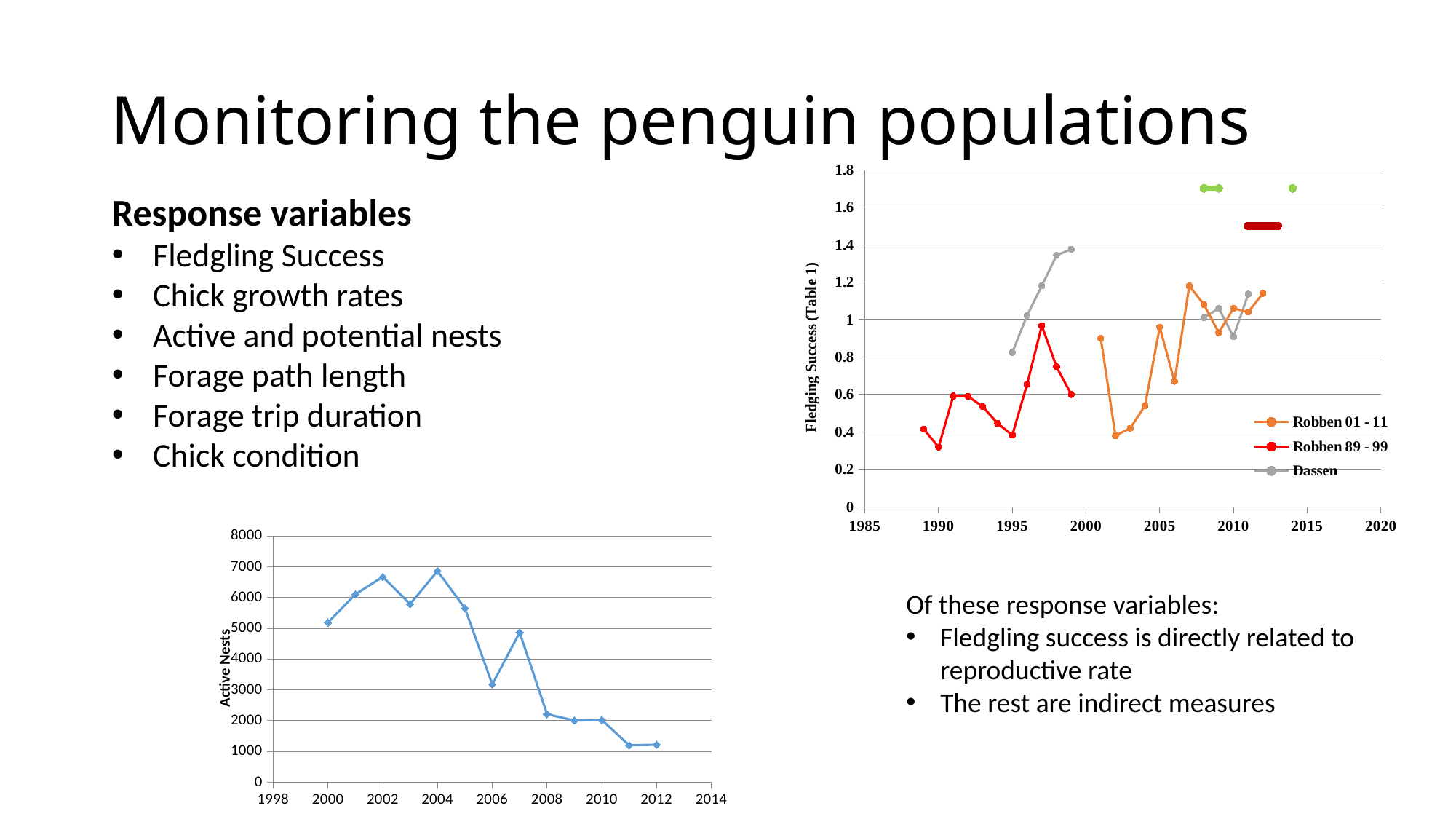
In the bottom-left Active Nests chart, do the values generally rise or fall from 2004 to 2012? fall What is the y-axis label of the top-right chart? Fledging Success (Table 1) In the bottom-left Active Nests chart, is the value for 2000 greater or less than 5000? greater In the top-right Fledging Success chart, is the Dassen value for 1999 greater or less than 1.2? greater What kind of chart is the top-right Fledging Success chart? line chart In the bottom-left Active Nests chart, is the value for 2006 greater or less than 4000? less How many series does the legend of the top-right Fledging Success chart list? 3 What kind of chart is the bottom-left chart showing Active Nests? line chart In the bottom-left Active Nests chart, which is larger, the value for 2007 or the value for 2008? 2007 In the bottom-left Active Nests chart, how many data points are plotted? 13